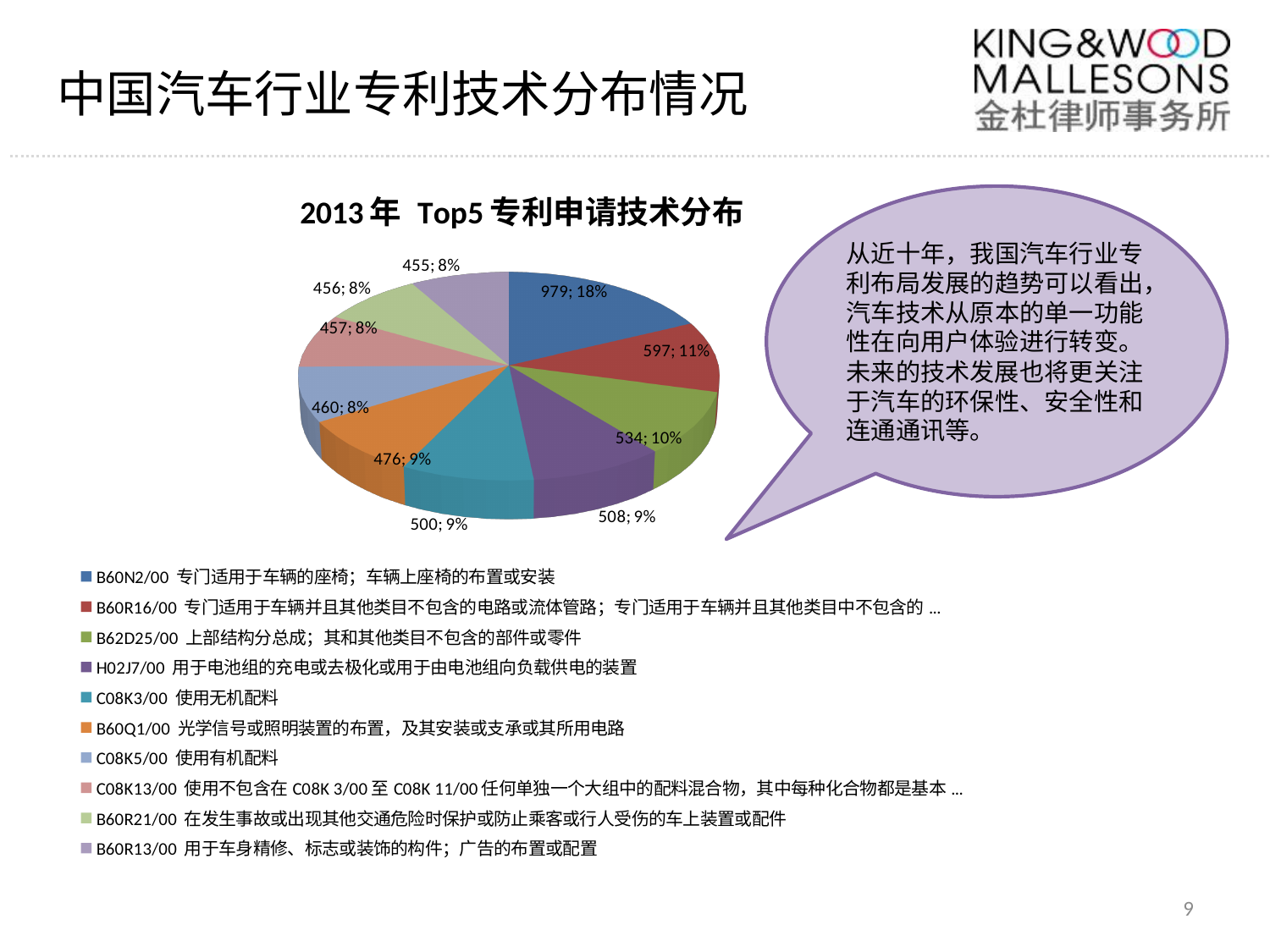
What is the value shown for B60N2/00 in the pie chart? 979 What is the value shown for C08K3/00 in the pie chart? 500 How many slices does the pie chart have? 10 Which is larger, the value for H02J7/00 or the value for B60Q1/00? H02J7/00 What is the title of the pie chart? 2013 年 Top5 专利申请技术分布 Which category has the smallest slice in the pie chart? B60R13/00 What kind of chart is shown on the slide? pie chart What share of the pie does B62D25/00 represent? 10% What share of the pie does B60N2/00 represent? 18% What is the difference between the values for B60N2/00 and B60R16/00? 382 What is the value shown for B60R16/00 in the pie chart? 597 Which category has the largest slice in the pie chart? B60N2/00